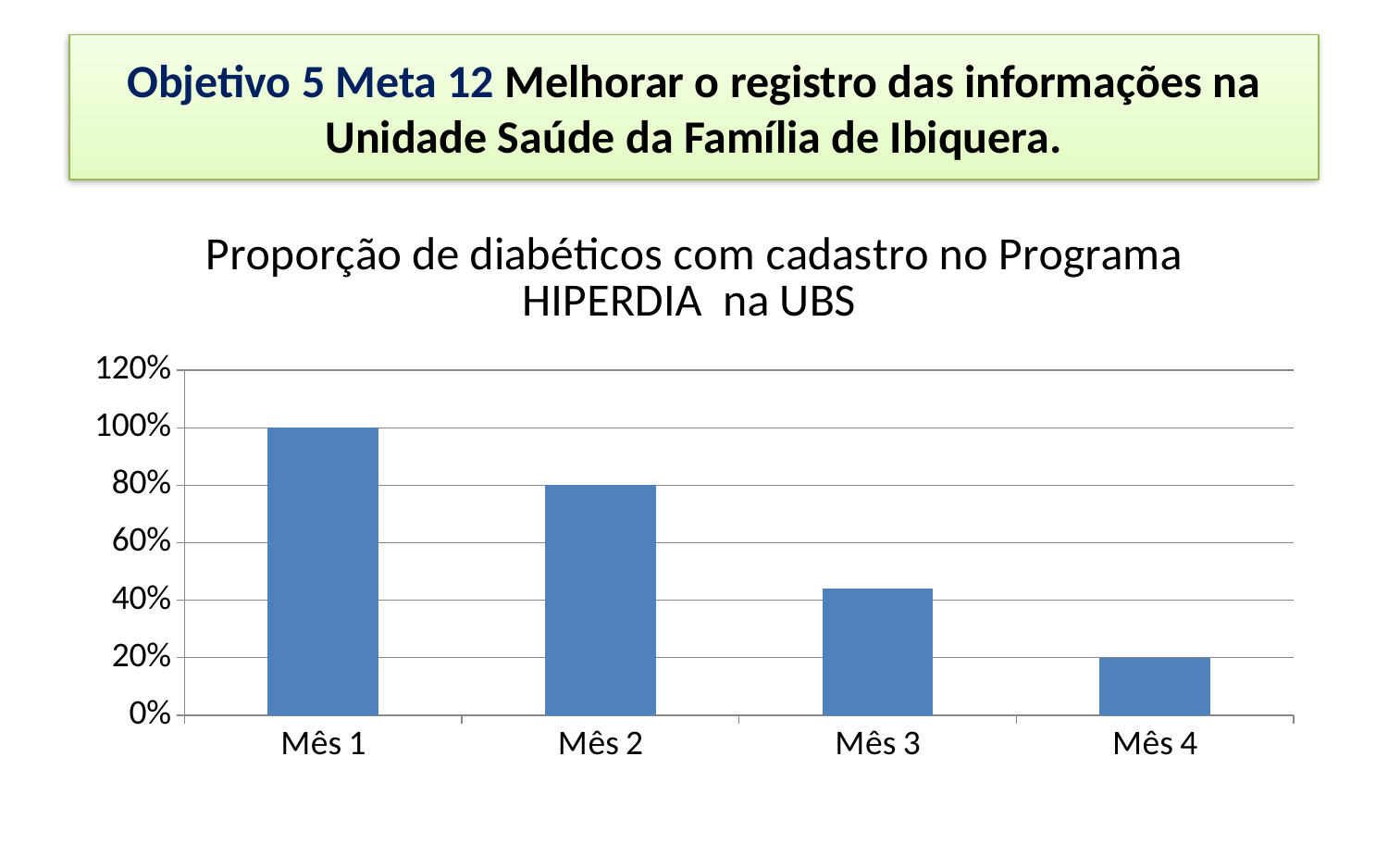
Which month has the lowest proportion? Mês 4 How many months are shown on the x axis? 4 What is the value for Mês 1? 100% Do the values rise or fall from Mês 1 to Mês 4? fall What is the difference between the values for Mês 2 and Mês 4? 60% What is the value for Mês 4? 20% What is the value for Mês 2? 80% What is the difference between the values for Mês 1 and Mês 2? 20% Which is larger, the value for Mês 2 or the value for Mês 3? Mês 2 Is the value for Mês 3 greater or less than 40%? greater What kind of chart is shown on the slide? bar chart Which month has the highest proportion? Mês 1